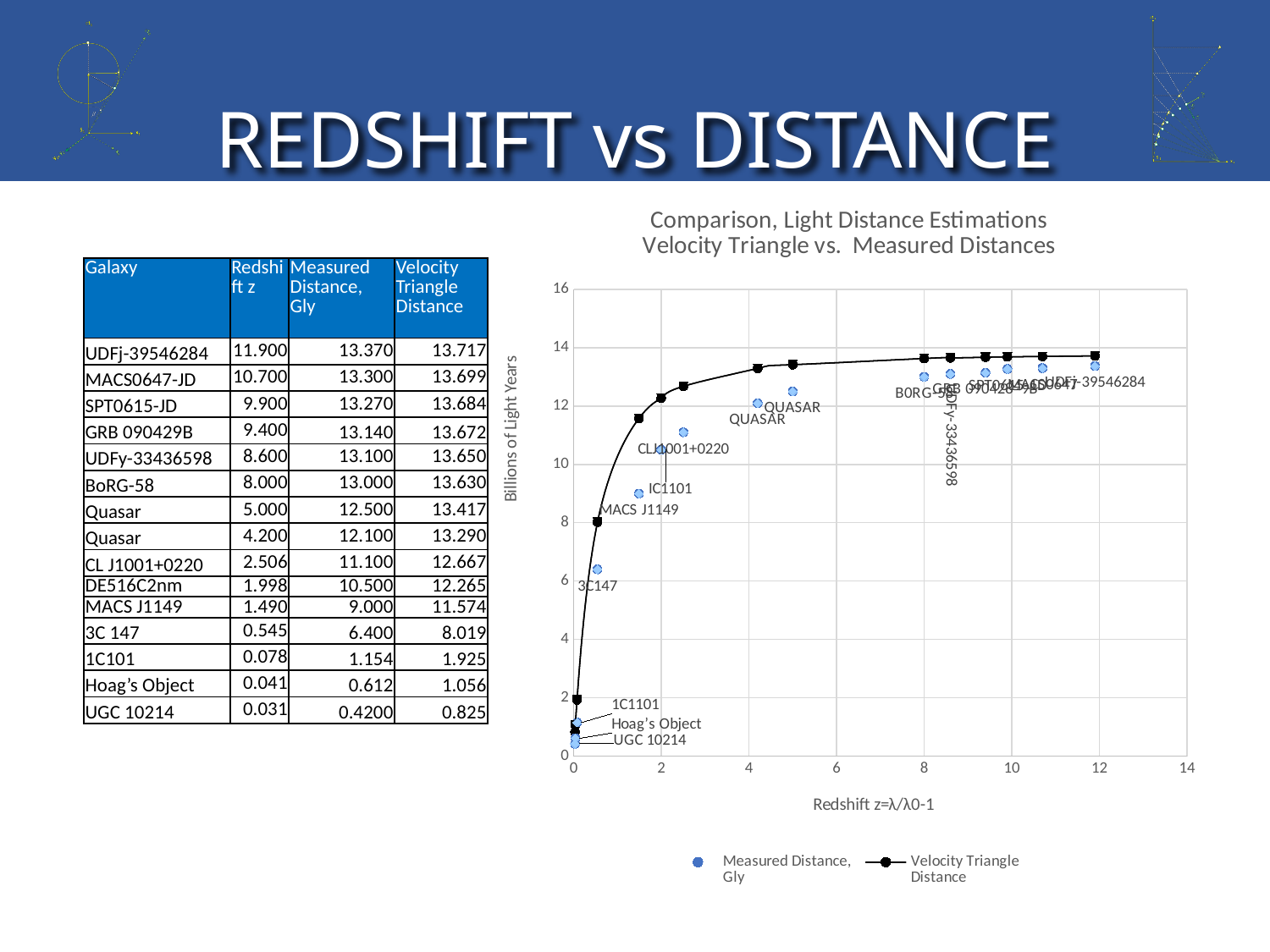
What is the title of the chart? Comparison, Light Distance Estimations Velocity Triangle vs. Measured Distances Which series is drawn as a black line with markers in the chart? Velocity Triangle Distance At a redshift of about 2, which series has the larger value: Measured Distance or Velocity Triangle Distance? Velocity Triangle Distance Is the Measured Distance value at a redshift of about 5 greater or less than 14? less Is the Measured Distance value at a redshift of about 0.5 (3C147) greater or less than 8? less What are the two series named in the chart legend? Measured Distance, Gly; Velocity Triangle Distance Is the Velocity Triangle Distance value at a redshift of about 12 greater or less than 12? greater How many series does the chart legend list? 2 What kind of chart is shown on the slide? Scatter chart Do the Velocity Triangle Distance values rise or fall as redshift increases along the x axis? Rise